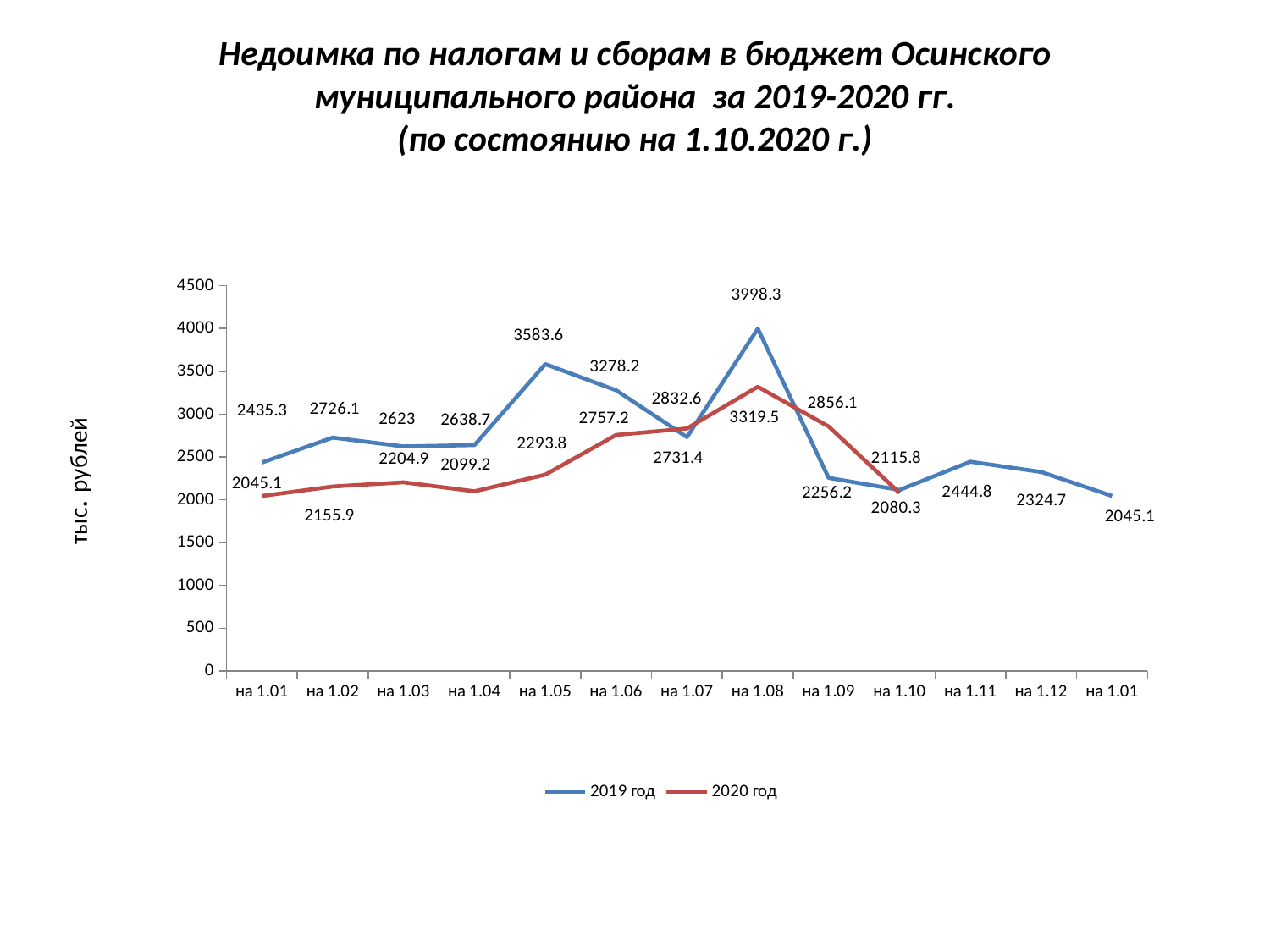
Is the value for 2019 год at на 1.05 greater or less than 3500? greater What is the value for 2019 год at на 1.08? 3998.3 How many series does the legend list? 2 What is the highest value of the 2020 год series? 3319.5 What is the label on the vertical axis? тыс. рублей What kind of chart is shown on the slide? line chart What is the lowest value of the 2020 год series? 2045.1 At which date does the 2019 год series reach its highest value? на 1.08 At на 1.07, which series has the larger value, 2019 год or 2020 год? 2020 год What is the difference between the 2019 год and 2020 год values at на 1.08? 678.8 What is the value for 2020 год at на 1.06? 2757.2 How many dates are shown on the x axis? 13